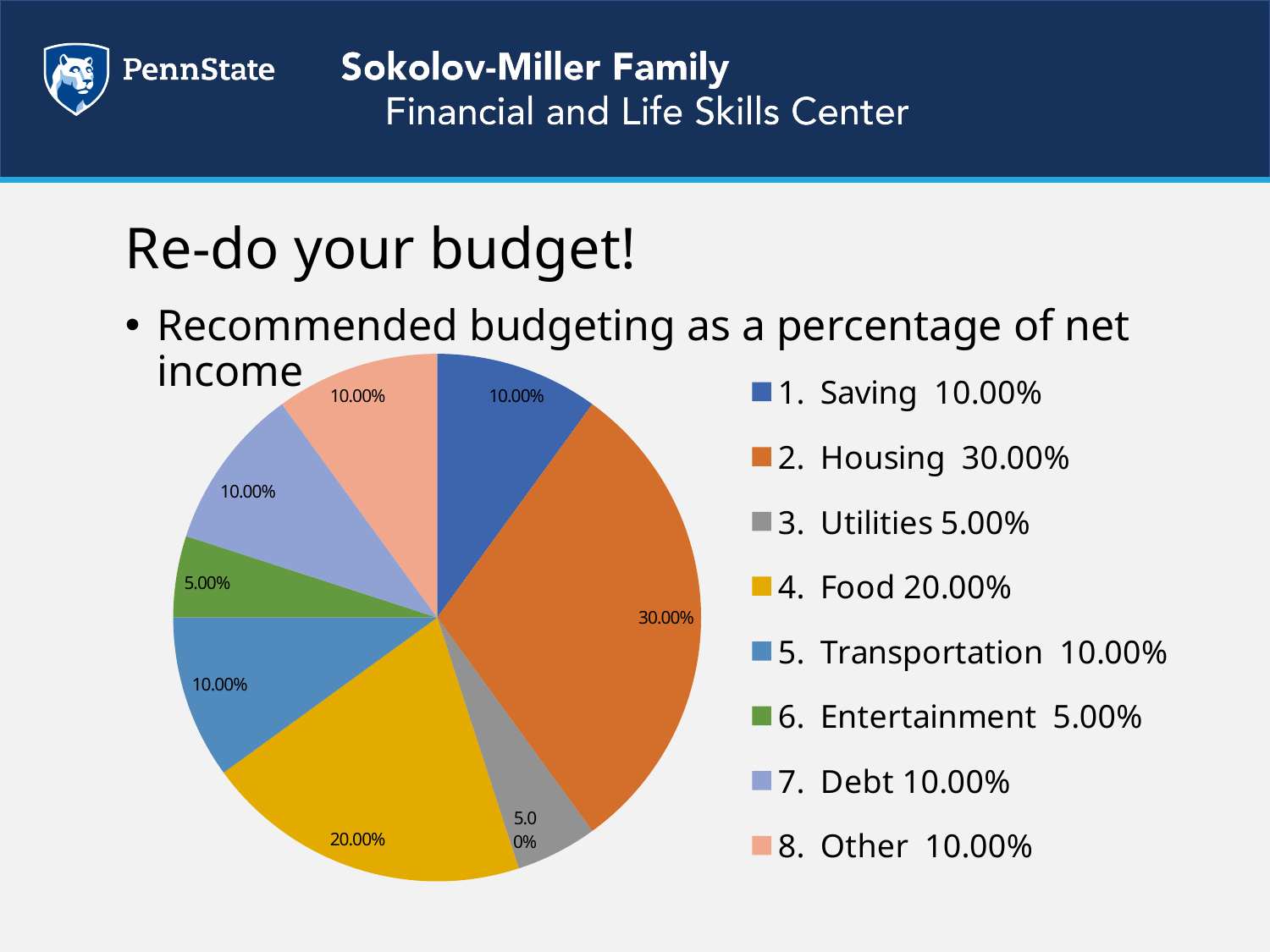
Which category is listed as number 7 in the legend? Debt How many categories does the legend list? 8 What percentage is shown for Utilities? 5.00% Which category has the largest slice of the pie? Housing What is the combined percentage of Utilities and Entertainment? 10.00% What percentage is shown for Housing? 30.00% What percentage is shown for Food? 20.00% What colour is the Housing slice? orange What is the difference between the Housing and Food percentages? 10.00% What percentage is shown for Transportation? 10.00% What kind of chart is shown on the slide? pie chart Which is larger, the slice for Food or the slice for Saving? Food